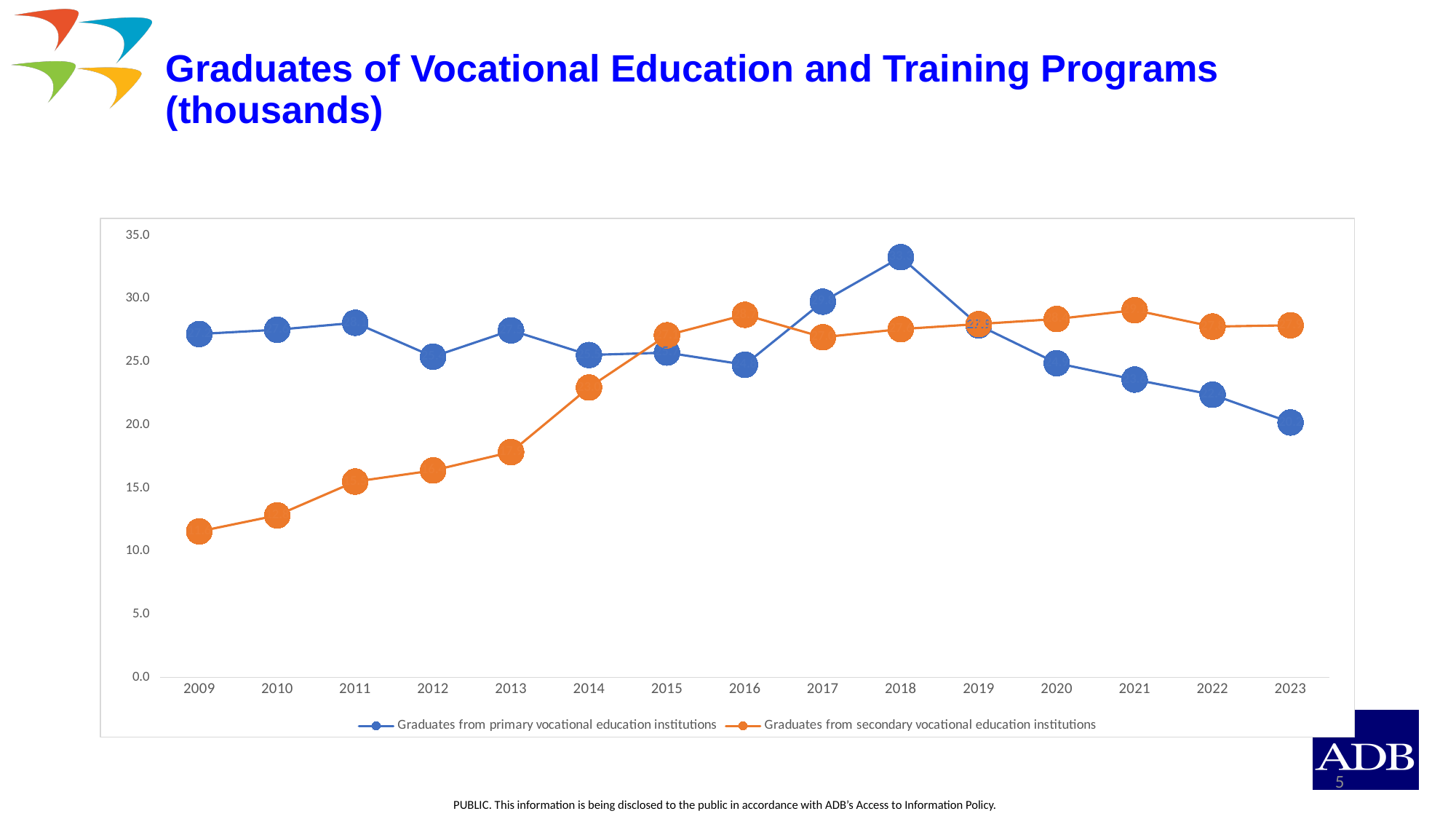
In which year do graduates from primary vocational education institutions reach their highest value? 2018 In which year do graduates from secondary vocational education institutions have their lowest value? 2009 Do graduates from secondary vocational education institutions rise or fall from 2009 to 2016? Rise Is the value for graduates from primary vocational education institutions in 2023 greater or less than 25.0? less What kind of chart is shown on the slide? Line chart In 2012, which series has the higher value: primary or secondary vocational education institutions? Graduates from primary vocational education institutions In which year do graduates from primary vocational education institutions have their lowest value? 2023 Is the value for graduates from secondary vocational education institutions in 2009 greater or less than 15.0? less Is the value for graduates from primary vocational education institutions in 2018 greater or less than 30.0? greater How many years are shown on the x axis? 15 How many series does the legend list? 2 In 2021, which series has the higher value: primary or secondary vocational education institutions? Graduates from secondary vocational education institutions